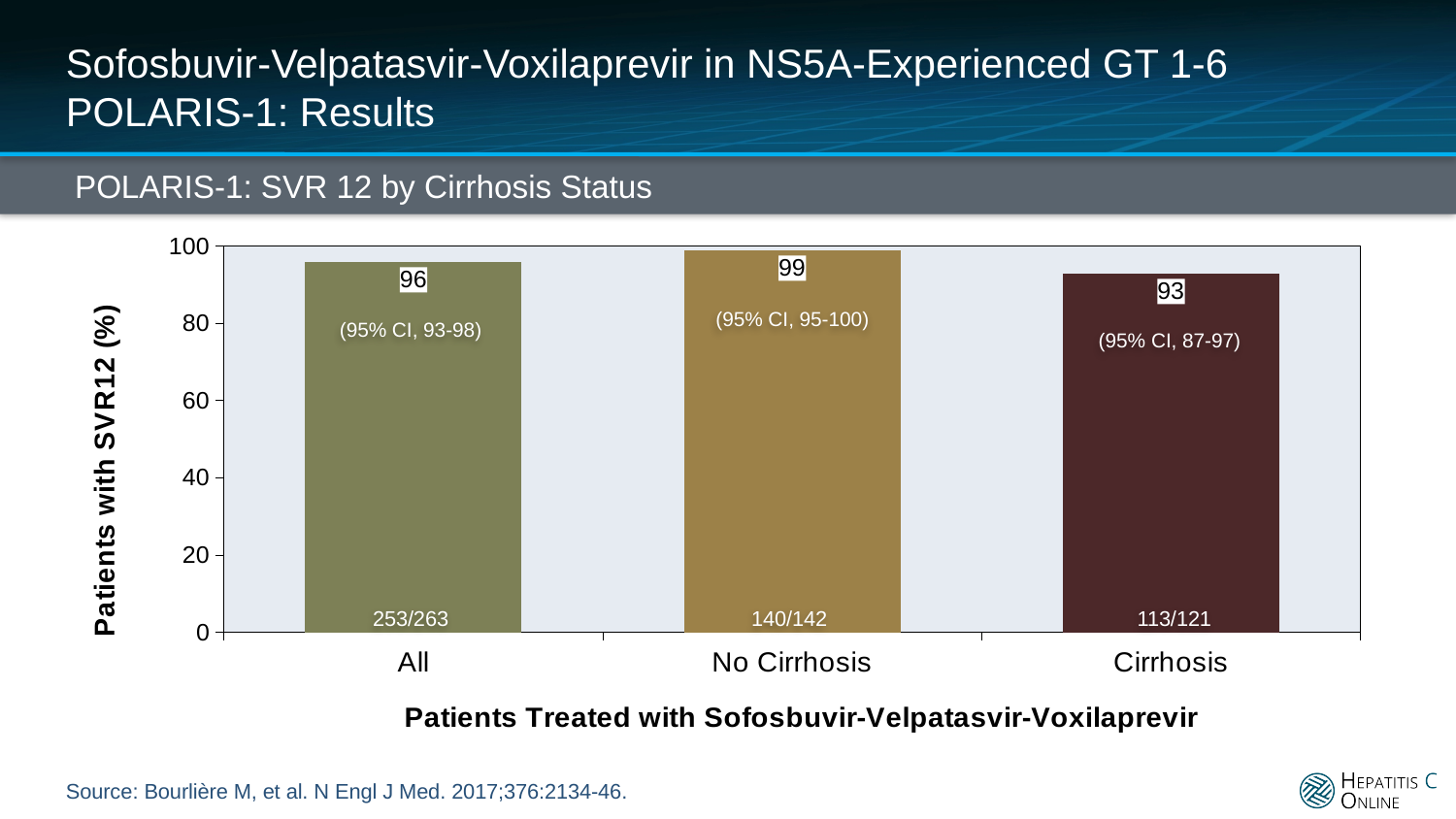
What fraction of patients is shown for the No Cirrhosis group? 140/142 Which group has the lowest SVR12 rate? Cirrhosis What is the SVR12 rate for the All group? 96 How many patient groups are shown on the chart? 3 What is the 95% confidence interval shown for the Cirrhosis group? 87-97 What is the SVR12 rate for patients with No Cirrhosis? 99 What kind of chart is shown on the slide? Bar chart Which group has the highest SVR12 rate? No Cirrhosis Which group has a higher SVR12 rate, All or Cirrhosis? All What is the SVR12 rate for patients with Cirrhosis? 93 What is the difference in SVR12 rate between the No Cirrhosis and Cirrhosis groups? 6 What is the title of the chart? POLARIS-1: SVR 12 by Cirrhosis Status